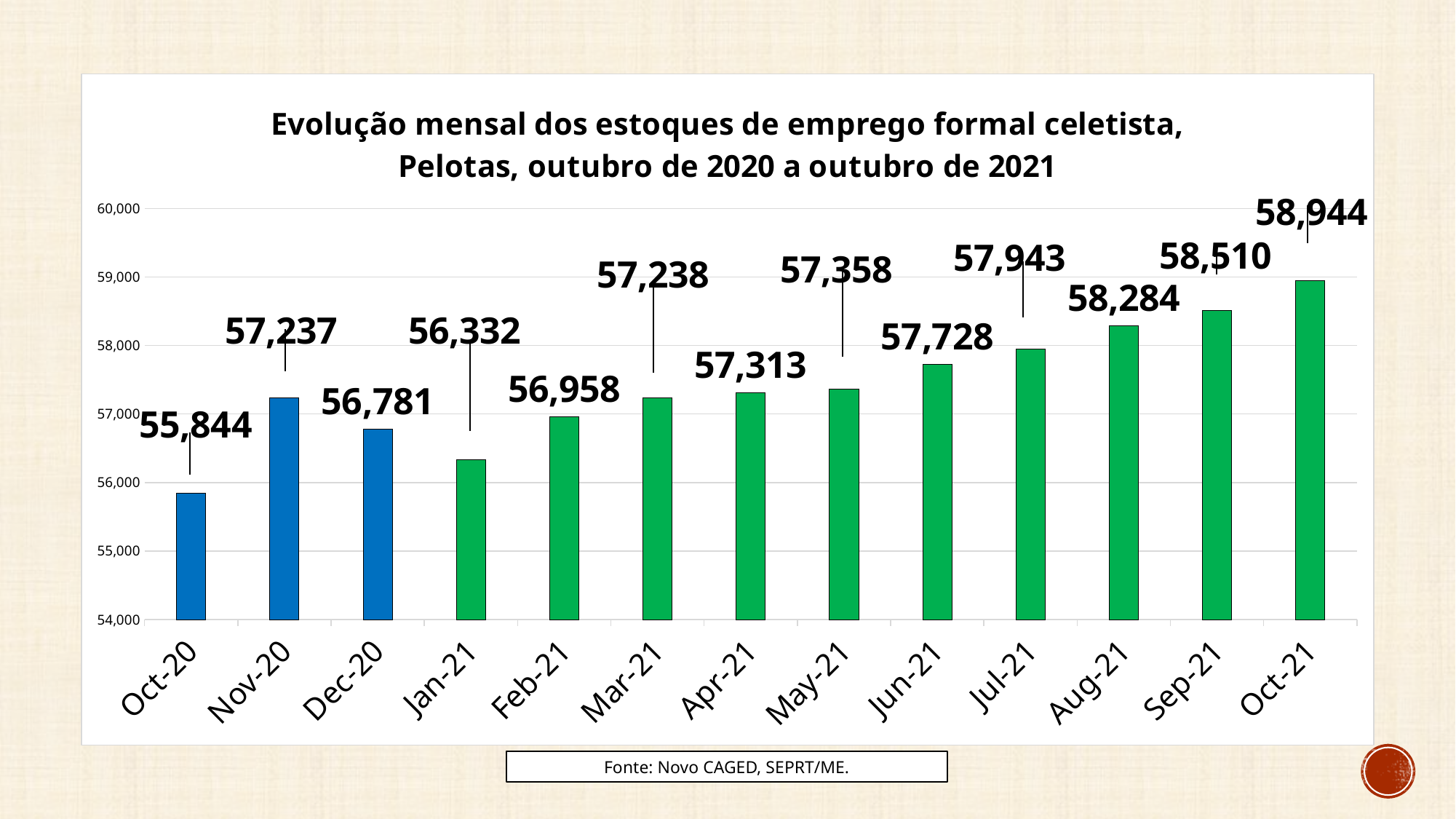
What is the value for Jun-21? 57,728 Do the values rise or fall from Jan-21 to Oct-21? rise Which is larger, the value for Nov-20 or the value for Jan-21? Nov-20 How many months are shown on the x axis? 13 What is the difference between the values for Oct-21 and Oct-20? 3,100 What is the value for Sep-21? 58,510 Which month has the lowest value? Oct-20 What kind of chart is shown on the slide? bar chart What is the difference between the values for Nov-20 and Dec-20? 456 What is the value for Oct-20? 55,844 Is the value for Aug-21 greater or less than 58,000? greater Which month has the highest value? Oct-21